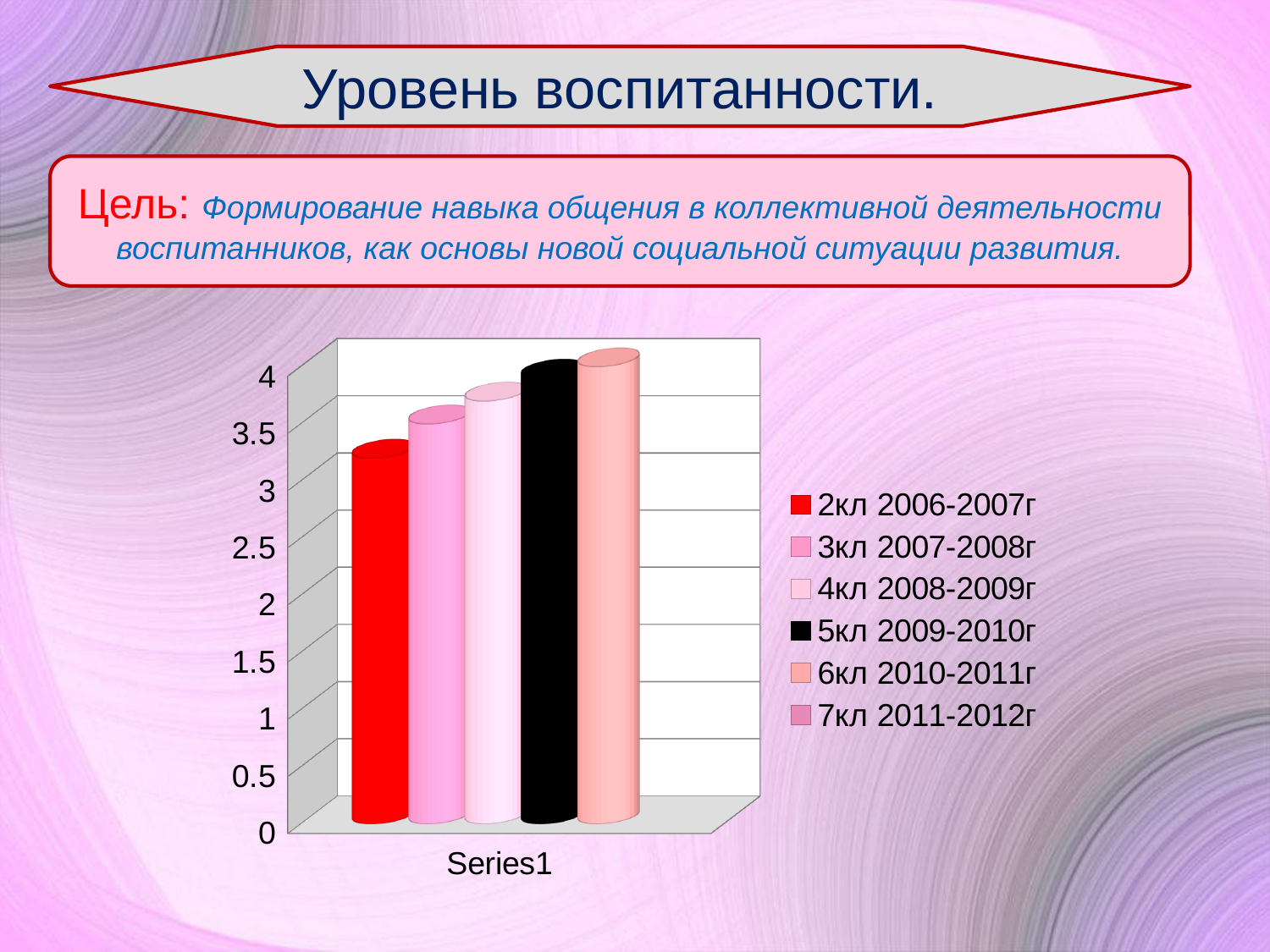
Is the value for 6кл 2010-2011г greater or less than 3.5? greater How many bars are plotted in the chart? 5 Which is larger, the value for 2кл 2006-2007г or the value for 4кл 2008-2009г? 4кл 2008-2009г What kind of chart is shown on the slide? bar chart What label is shown under the bars on the horizontal axis of the chart? Series1 How many entries does the chart legend list? 6 Is the value for 2кл 2006-2007г greater or less than 3? greater Which is larger, the value for 3кл 2007-2008г or the value for 5кл 2009-2010г? 5кл 2009-2010г Do the bar values rise or fall from left to right across the chart? rise Which legend entry has the lowest bar in the chart? 2кл 2006-2007г Is the value for 5кл 2009-2010г greater or less than 3.5? greater